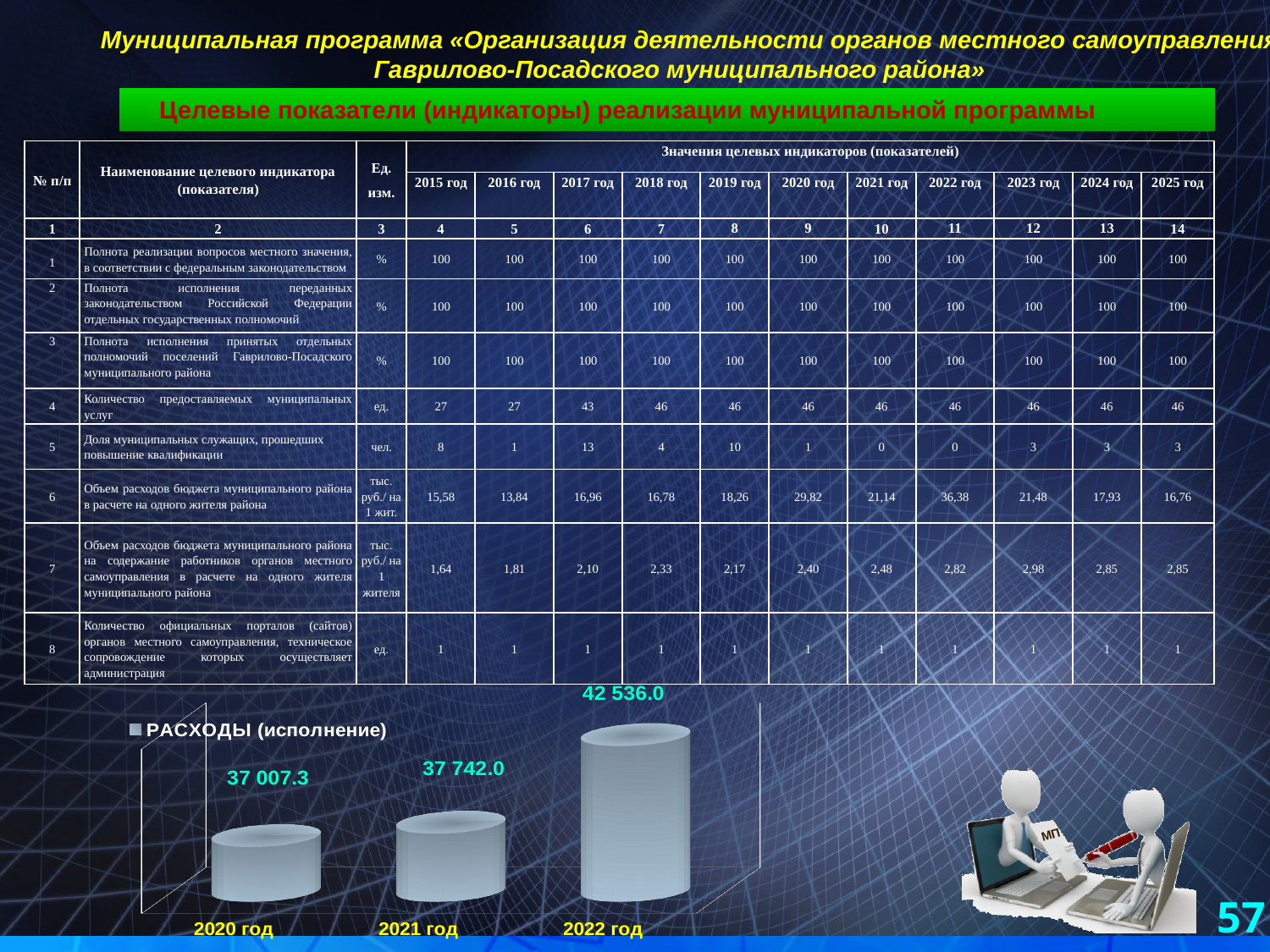
What is the difference between the values for 2021 год and 2020 год in the chart? 734.7 Which year has the lowest value in the chart? 2020 год What is the difference between the values for 2022 год and 2021 год in the chart? 4 794.0 What kind of chart is shown at the bottom of the slide? bar chart How many categories (years) are shown in the chart? 3 What is the value for 2022 год in the chart? 42 536.0 Which is larger in the chart, the value for 2020 год or the value for 2022 год? 2022 год Do the values in the chart rise or fall from 2020 год to 2022 год? rise What is the value for 2020 год in the chart? 37 007.3 What is the value for 2021 год in the chart? 37 742.0 Which year has the highest value in the chart? 2022 год How many series does the chart legend list? 1